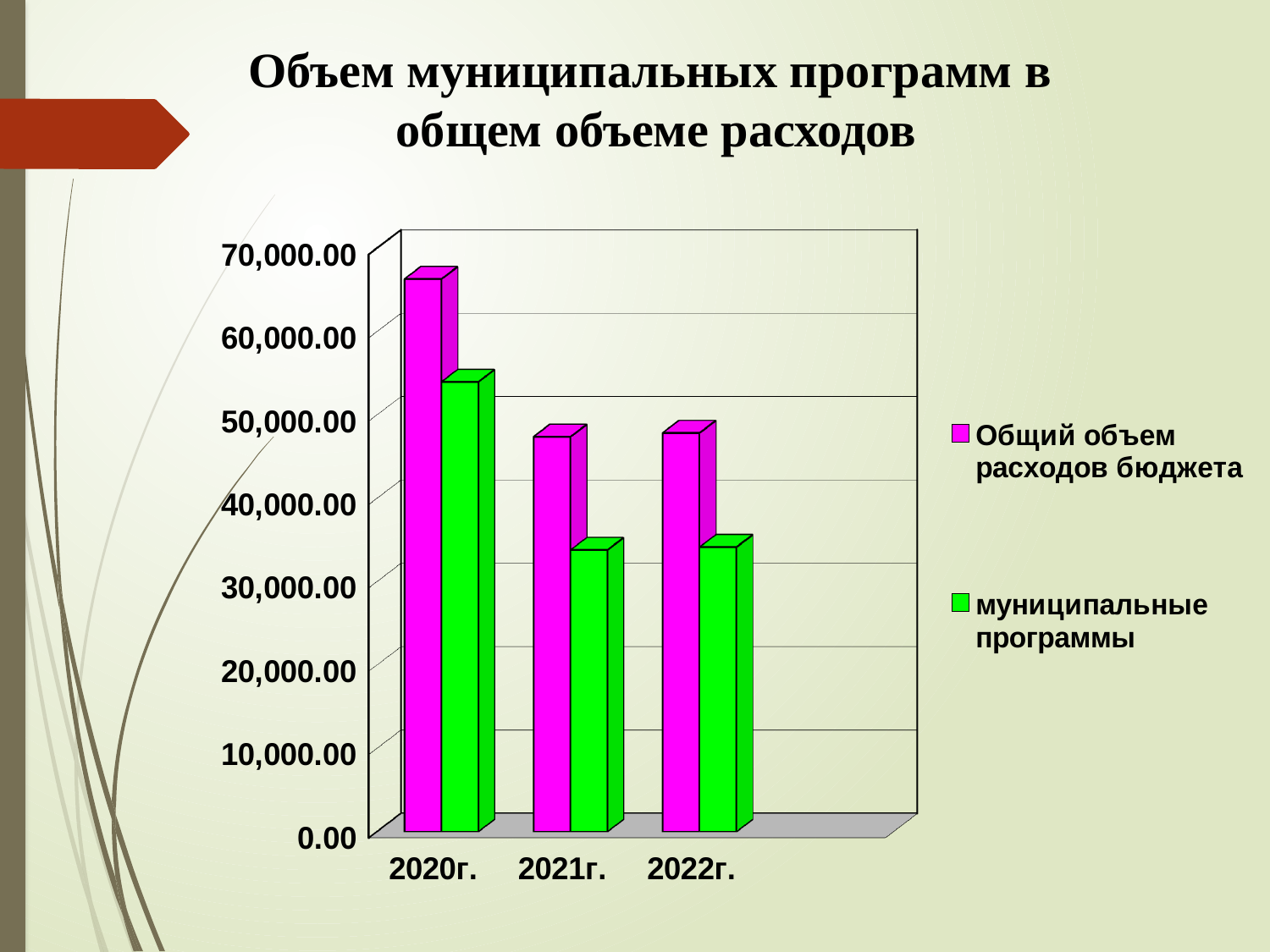
Is the value for Общий объем расходов бюджета in 2021г. greater or less than 50,000.00? less Does the value for Общий объем расходов бюджета rise or fall from 2020г. to 2021г.? fall Is the value for муниципальные программы in 2020г. greater or less than 50,000.00? greater Is the value for муниципальные программы in 2022г. greater or less than 30,000.00? greater What kind of chart is shown on the slide? bar chart How many series does the legend list? 2 In 2020г., which is larger: Общий объем расходов бюджета or муниципальные программы? Общий объем расходов бюджета Which year has the highest value for муниципальные программы? 2020г. How many years are shown on the x axis? 3 Which year has the highest value for Общий объем расходов бюджета? 2020г. What colour are the bars for муниципальные программы? green